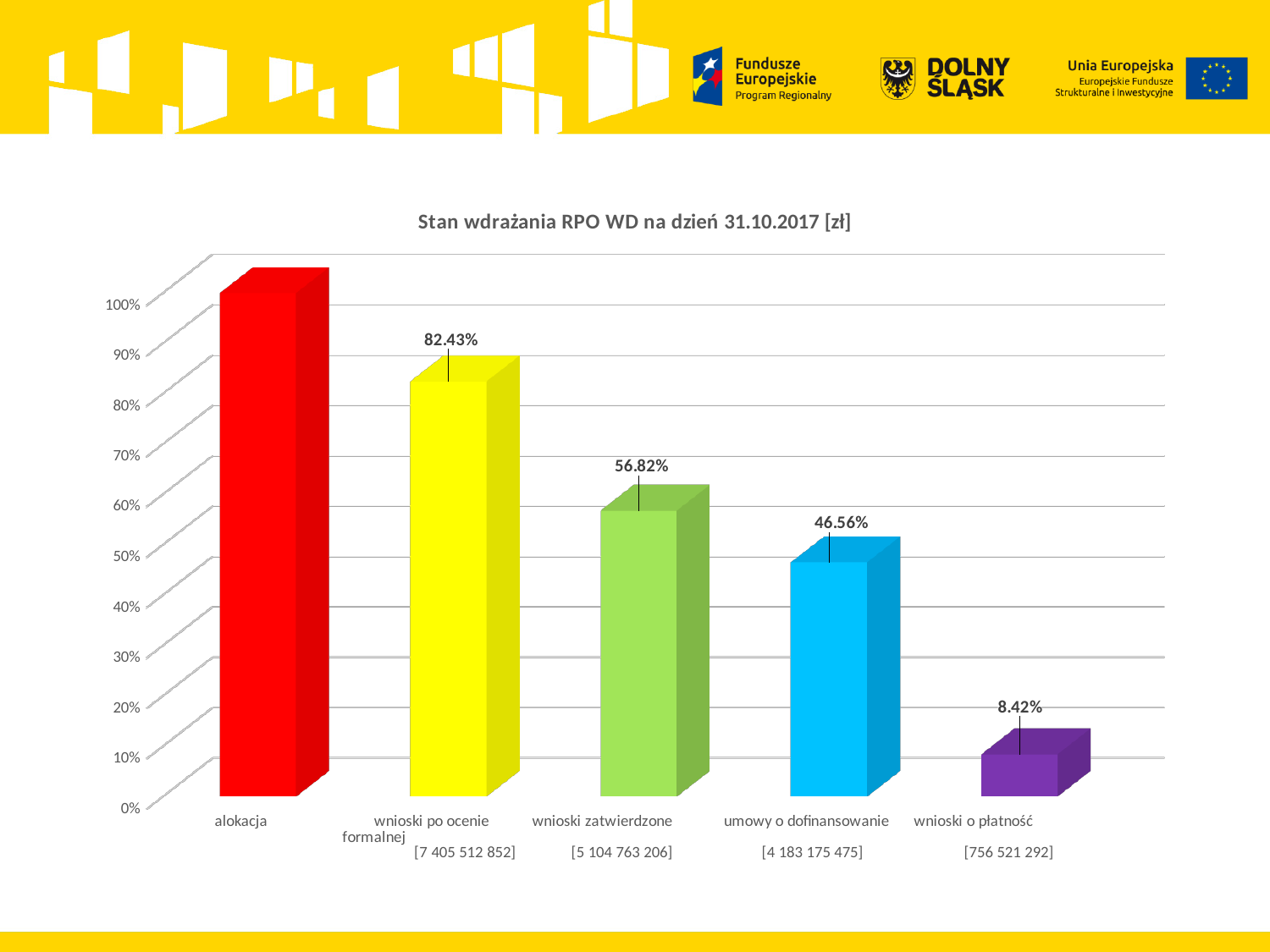
What is the value for wnioski po ocenie formalnej? 82.43% Which is larger, wnioski zatwierdzone or umowy o dofinansowanie? wnioski zatwierdzone Which category has the lowest value? wnioski o płatność What is the title of the chart? Stan wdrażania RPO WD na dzień 31.10.2017 [zł] What is the difference between wnioski po ocenie formalnej and wnioski zatwierdzone? 25.61% What is the value for wnioski o płatność? 8.42% What is the difference between umowy o dofinansowanie and wnioski o płatność? 38.14% Which category has the highest bar? alokacja What is the value for wnioski zatwierdzone? 56.82% What is the value for umowy o dofinansowanie? 46.56% Is the value for alokacja greater or less than 90%? greater How many categories are shown on the x axis? 5